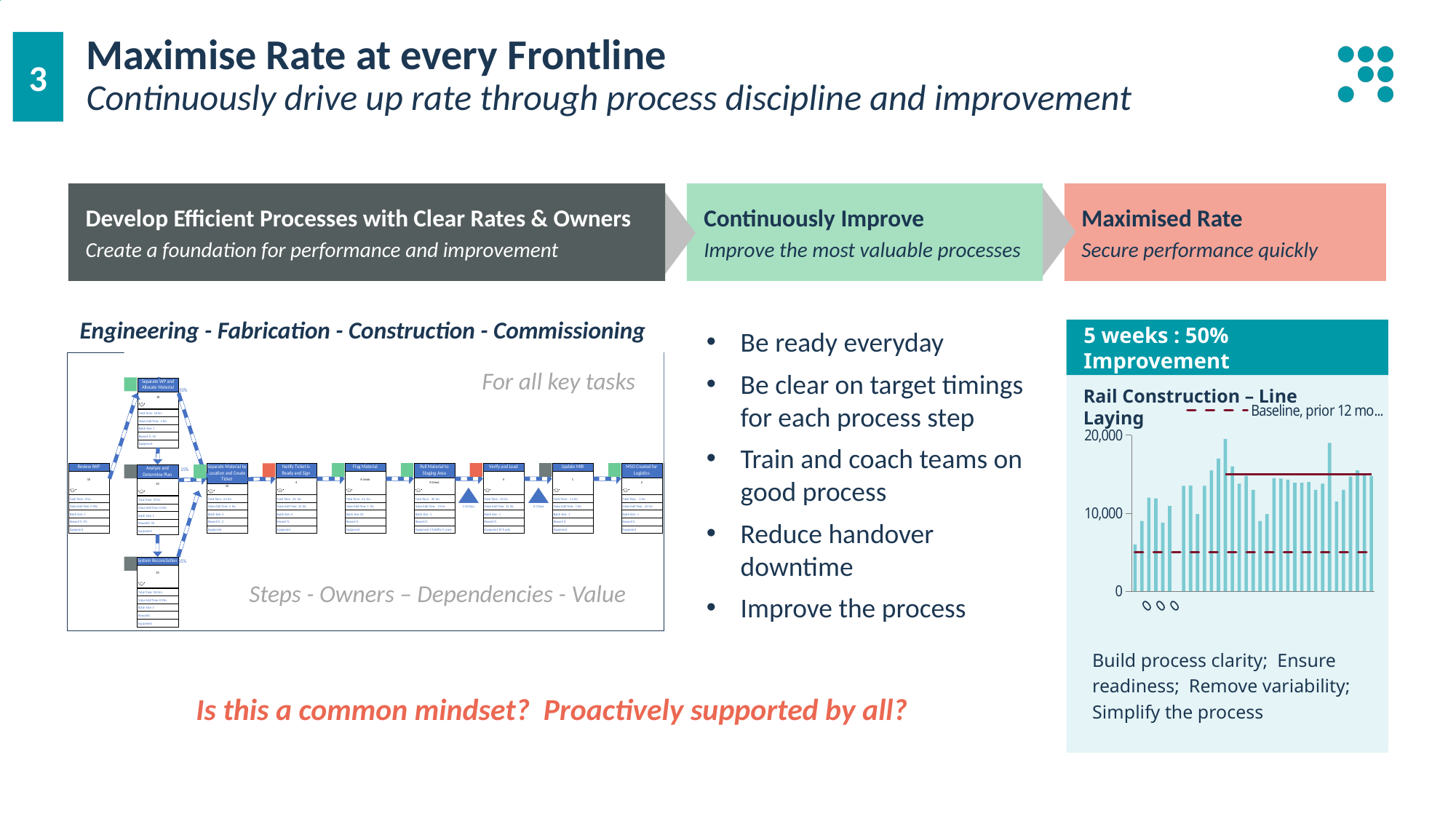
In the Rail Construction – Line Laying chart, is the first bar on the left greater or less than 10,000? less In the Rail Construction – Line Laying chart, is the dashed baseline line greater or less than 10,000? less What kind of chart is shown under the heading 'Rail Construction – Line Laying'? combination bar and line chart In the Rail Construction – Line Laying chart, which is larger: the first bar on the left or the last bar on the right? the last bar on the right In the Rail Construction – Line Laying chart, is the tallest bar greater or less than 10,000? greater In the Rail Construction – Line Laying chart, do the bar values generally rise or fall from left to right along the x axis? rise What is the title of the chart on the right side of the slide? Rail Construction – Line Laying What is the highest value shown on the y axis of the Rail Construction – Line Laying chart? 20,000